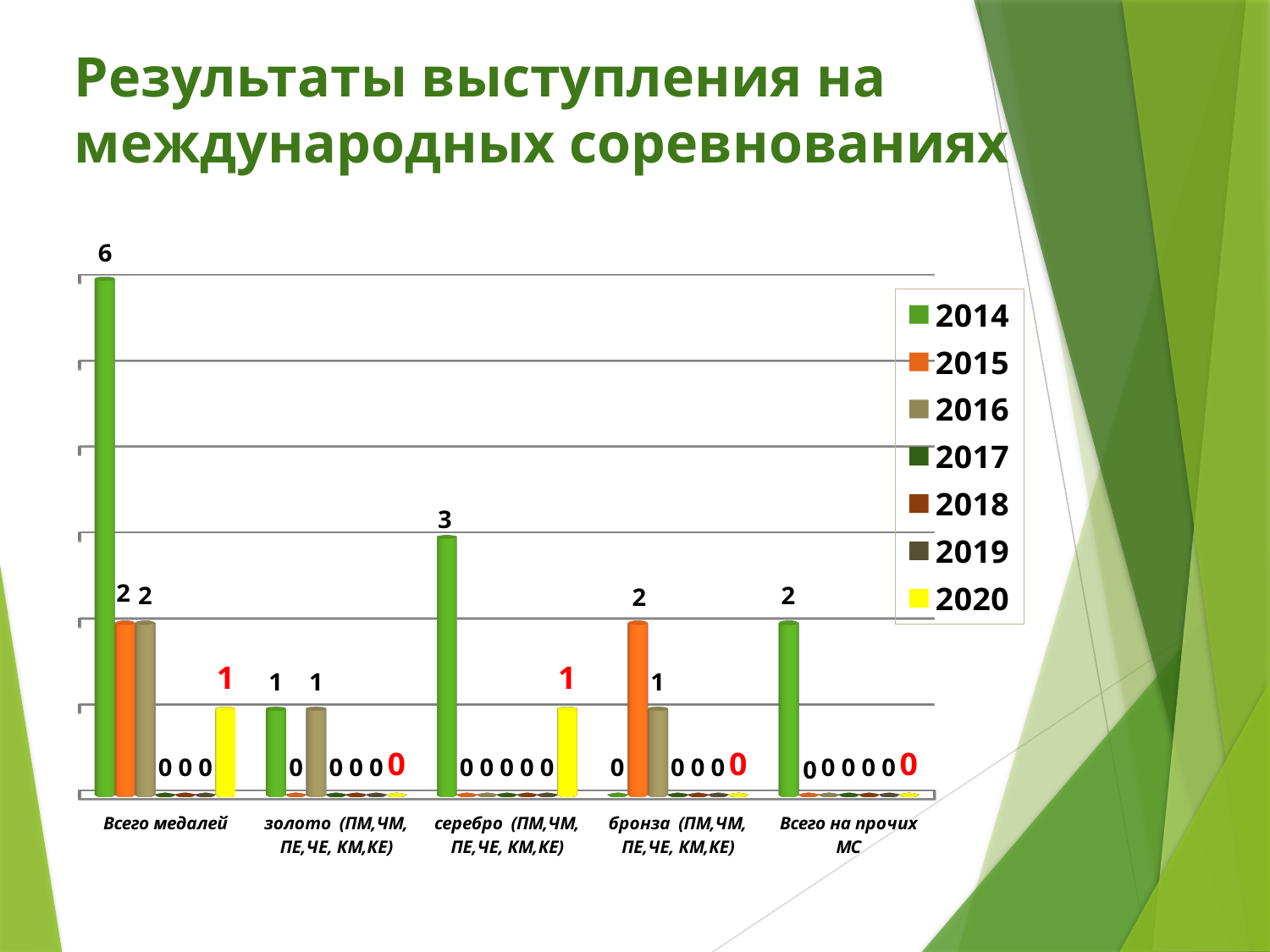
How many series does the legend list? 7 What is the value for 2015 in the "бронза" category? 2 What is the value for 2014 in the "Всего на прочих МС" category? 2 Which is larger in the "бронза" category: the value for 2015 or the value for 2016? 2015 How many categories are shown on the x axis? 5 What kind of chart is shown on the slide? bar chart What is the value for 2014 in the "серебро" category? 3 What is the value for 2020 in the "Всего медалей" category? 1 What is the difference between the 2014 and 2015 values in the "Всего медалей" category? 4 What is the value for 2014 in the "Всего медалей" category? 6 Which year has the highest value in the "Всего медалей" category? 2014 Which legend entry is shown in yellow? 2020